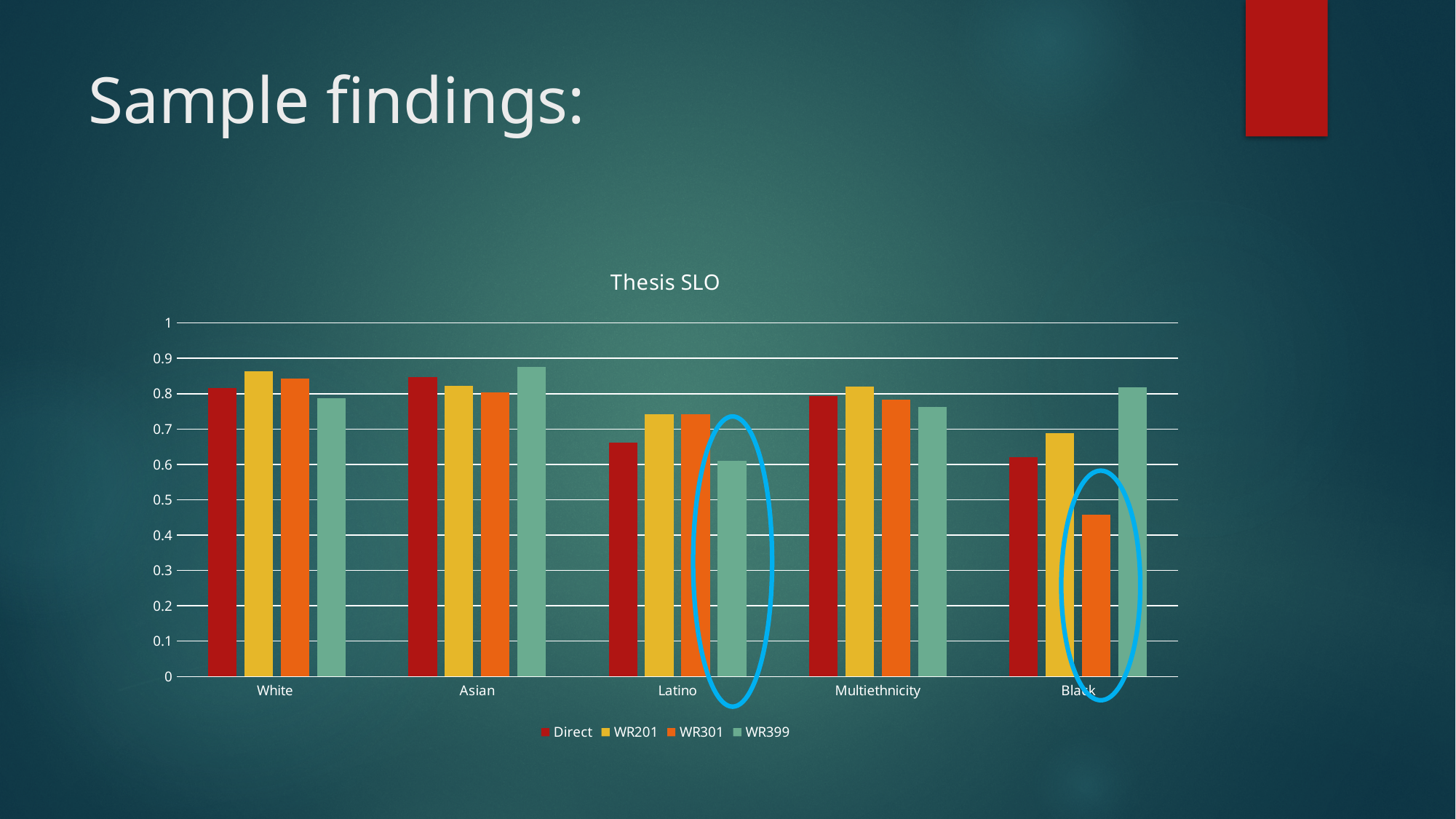
For the Black category, which is larger: the WR399 value or the WR301 value? WR399 What is the title of the chart on the slide? Thesis SLO Which category has the highest WR399 value in the Thesis SLO chart? Asian Which category has the lowest WR399 value in the Thesis SLO chart? Latino Which category has the lowest WR301 value in the Thesis SLO chart? Black What kind of chart is shown under the title "Thesis SLO"? bar chart Is the WR399 value for Asian greater or less than 0.8? greater Is the Direct value for Latino greater or less than 0.7? less How many categories are shown on the x axis of the Thesis SLO chart? 5 How many series does the legend of the Thesis SLO chart list? 4 Is the WR301 value for Black greater or less than 0.5? less